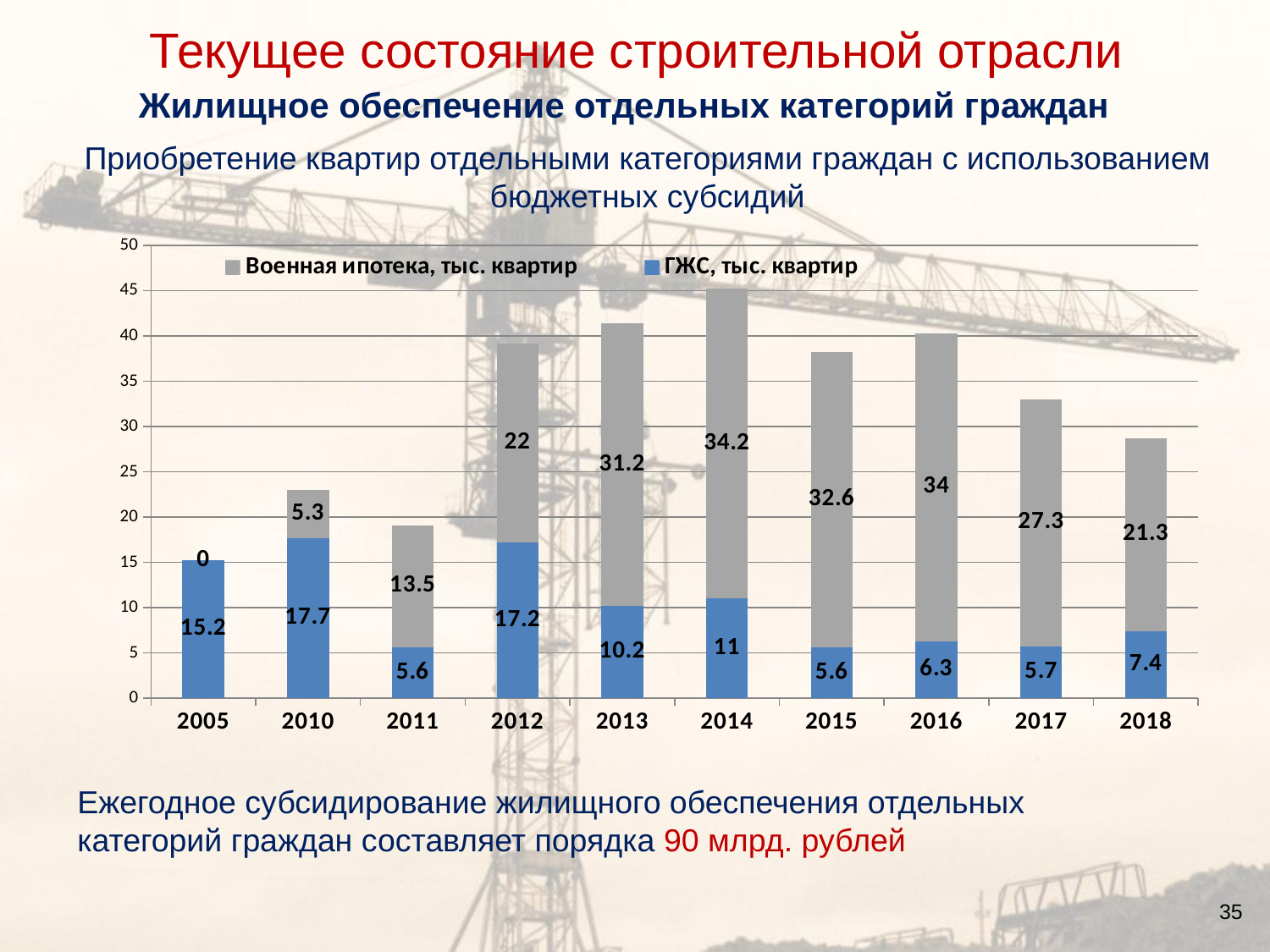
Which is larger: the ГЖС, тыс. квартир value for 2012 or for 2013? 2012 In which year is the Военная ипотека, тыс. квартир value the highest? 2014 Which colour represents ГЖС, тыс. квартир in the chart? Blue What is the value of Военная ипотека, тыс. квартир for 2005? 0 What is the value of ГЖС, тыс. квартир for 2010? 17.7 What is the total of the stacked bar for 2014? 45.2 In which year is the ГЖС, тыс. квартир value the highest? 2010 What kind of chart is shown on the slide? Stacked bar chart How many series does the legend list? 2 How many years are shown on the x axis? 10 What is the difference between the Военная ипотека, тыс. квартир values for 2016 and 2018? 12.7 What is the value of Военная ипотека, тыс. квартир for 2014? 34.2